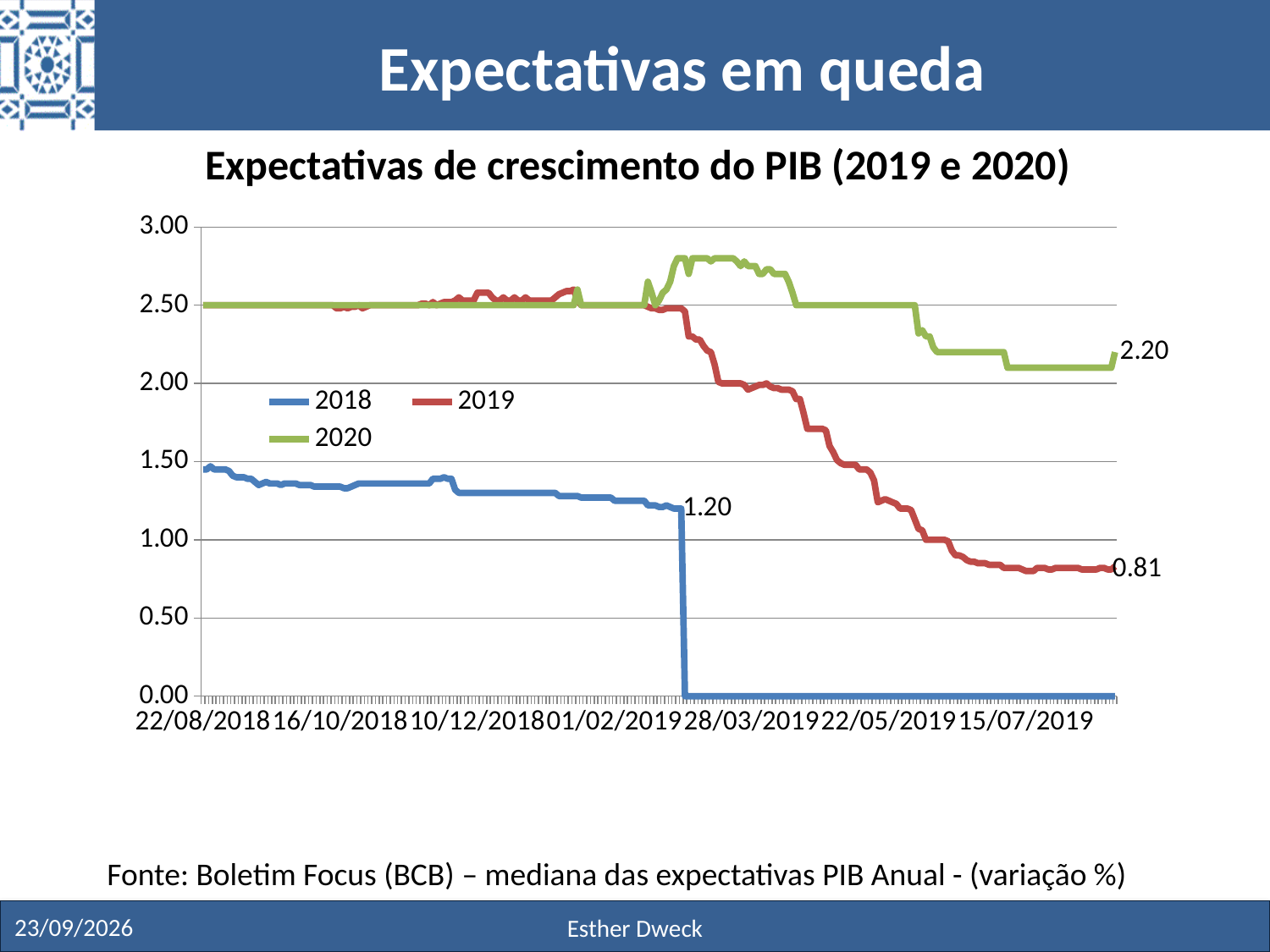
Is the value of the 2019 series at 22/08/2018 greater or less than 2.00? greater Does the 2019 series rise or fall overall from left to right? fall Is the value of the 2018 series at 22/08/2018 greater or less than 1.00? greater What is the title of the chart? Expectativas de crescimento do PIB (2019 e 2020) What is the last labelled value of the 2020 series? 2.20 Which series has the lowest values at the start of the chart (22/08/2018)? 2018 At the right end of the chart, which series has the higher value, 2019 or 2020? 2020 What is the last labelled value of the 2019 series? 0.81 How many series does the legend list? 3 What value is labelled on the 2018 series just before it drops to zero? 1.20 What kind of chart is shown on the slide? line chart What is the difference between the final labelled values of the 2020 and 2019 series? 1.39